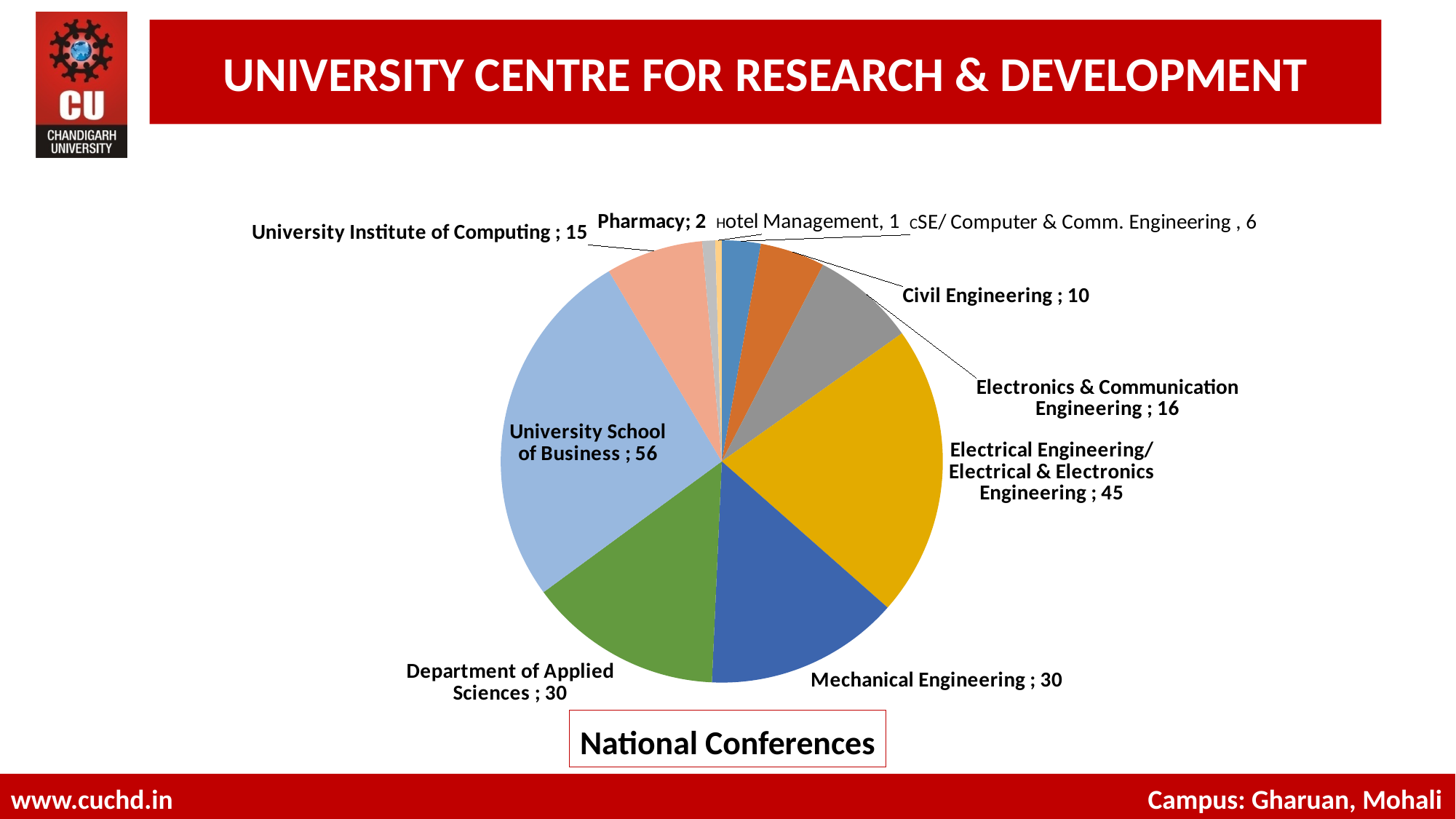
What is the title shown below the pie chart? National Conferences What kind of chart is shown on the slide? pie chart What is the value for Civil Engineering? 10 Which is larger, the value for Electronics & Communication Engineering or the value for University Institute of Computing? Electronics & Communication Engineering What is the difference between the values for University School of Business and Electrical Engineering/Electrical & Electronics Engineering? 11 What is the difference between the values for Civil Engineering and CSE/Computer & Comm. Engineering? 4 What is the value for Hotel Management? 1 Which category has the smallest slice of the pie? Hotel Management How many categories are shown in the pie chart? 10 How many national conferences are shown for University School of Business? 56 Which category has the largest slice of the pie? University School of Business What is the value for Electrical Engineering/Electrical & Electronics Engineering? 45